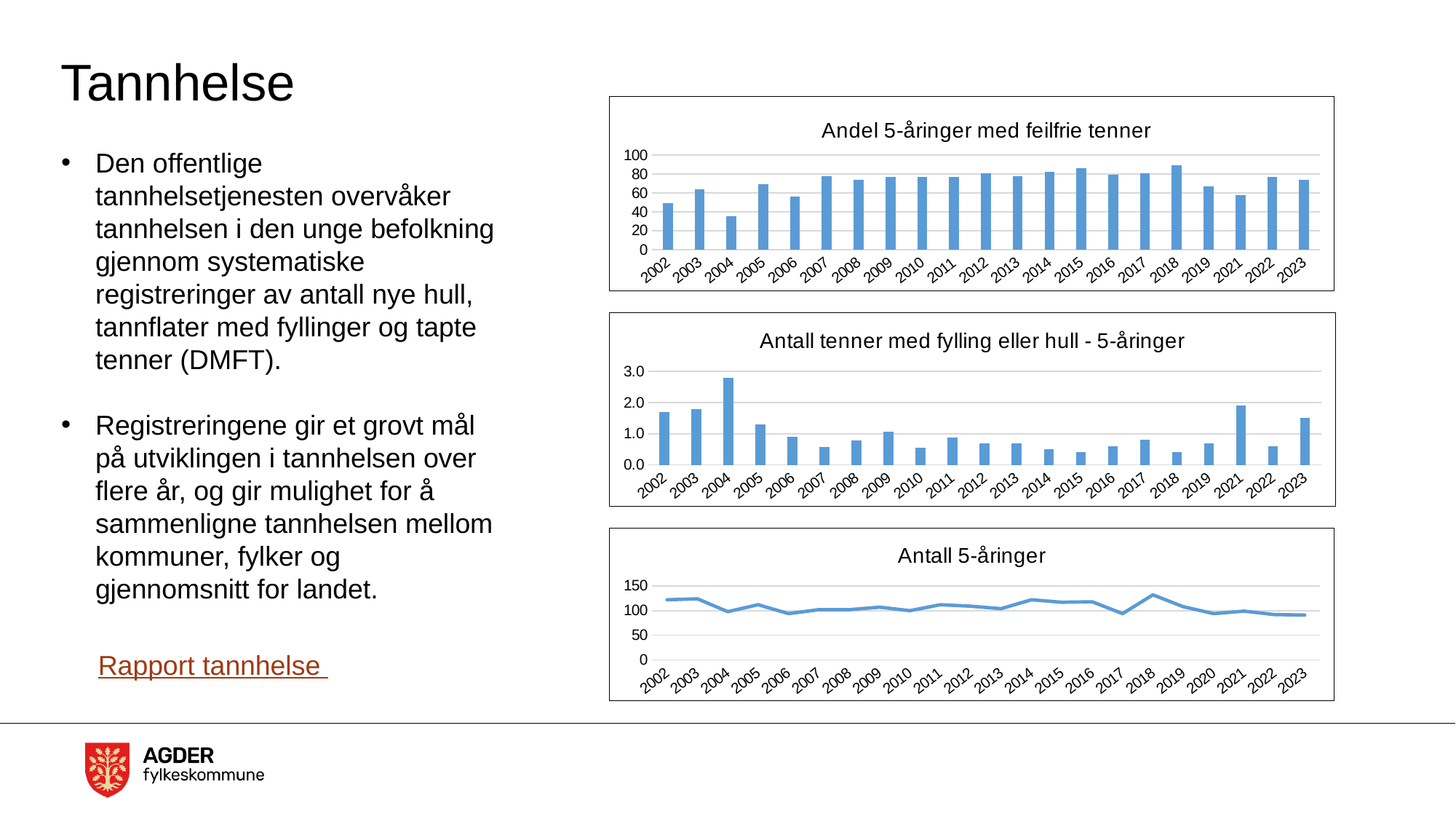
In the chart "Andel 5-åringer med feilfrie tenner", is the value for 2018 greater or less than 80? greater In the chart "Antall 5-åringer", is the value for 2023 greater or less than 100? less In the chart "Andel 5-åringer med feilfrie tenner", which year has the lowest value? 2004 What kind of chart is "Antall 5-åringer"? line chart In the chart "Antall tenner med fylling eller hull - 5-åringer", is the value for 2004 greater or less than 2.0? greater In the chart "Antall 5-åringer", which year has the highest value? 2018 In the chart "Antall tenner med fylling eller hull - 5-åringer", which is larger, the value for 2021 or the value for 2022? 2021 What kind of chart is "Andel 5-åringer med feilfrie tenner"? bar chart How many years are plotted in the chart "Antall 5-åringer"? 22 In the chart "Antall tenner med fylling eller hull - 5-åringer", which year has the highest value? 2004 In the chart "Andel 5-åringer med feilfrie tenner", which year has the highest value? 2018